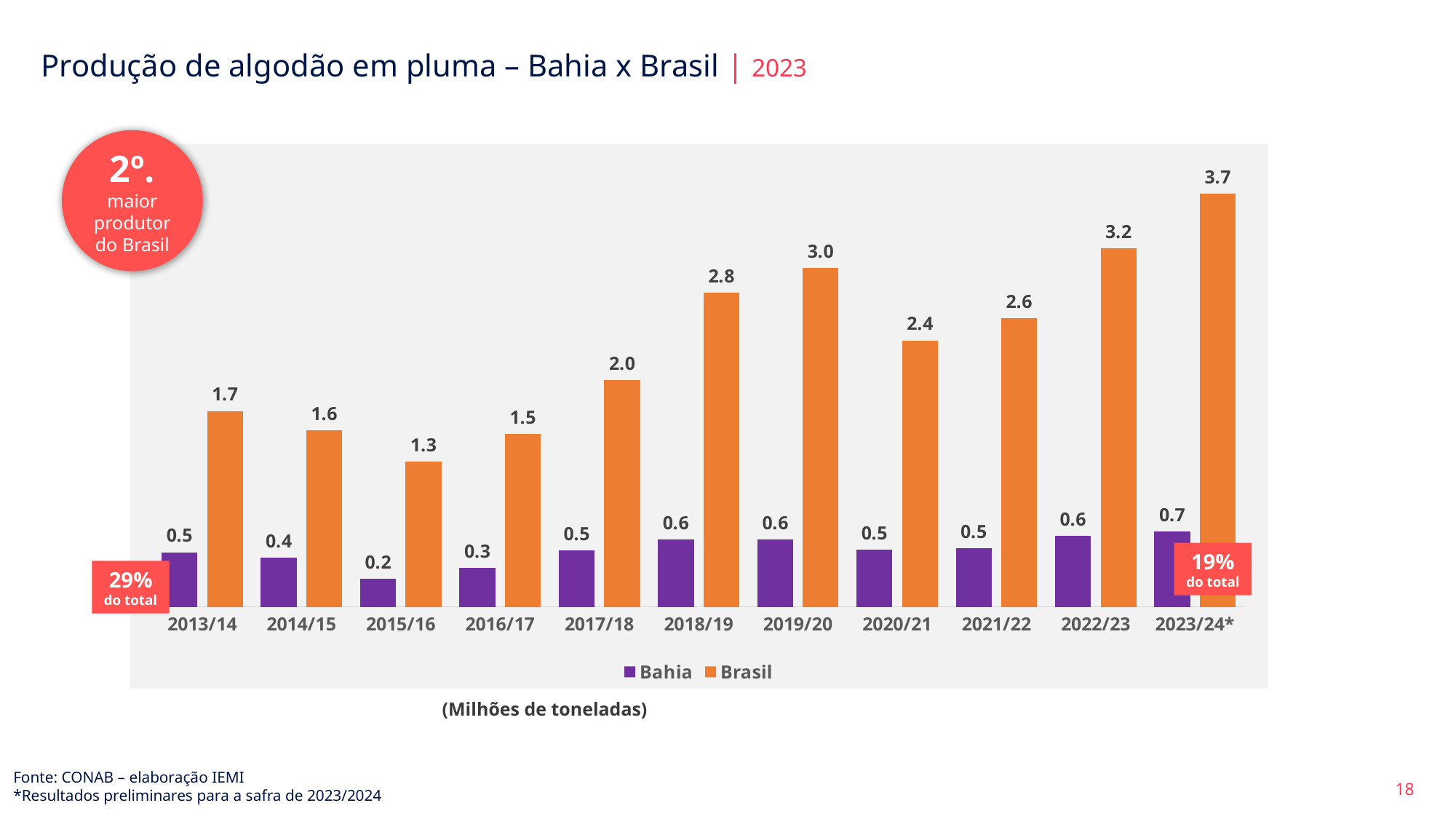
In which season is the Bahia value lowest? 2015/16 What kind of chart is shown on the slide? Bar chart In which season is the Brasil value highest? 2023/24* What is the value for Brasil in 2023/24*? 3.7 How many series does the legend list? 2 What unit is stated below the chart? Milhões de toneladas What is the value for Brasil in 2019/20? 3.0 What is the difference between the Brasil and Bahia values in 2022/23? 2.6 How many seasons are shown on the x axis? 11 What is the value for Bahia in 2015/16? 0.2 Do the Brasil values generally rise or fall from 2020/21 to 2023/24*? Rise Which is larger, the Brasil value in 2018/19 or the Brasil value in 2020/21? 2018/19